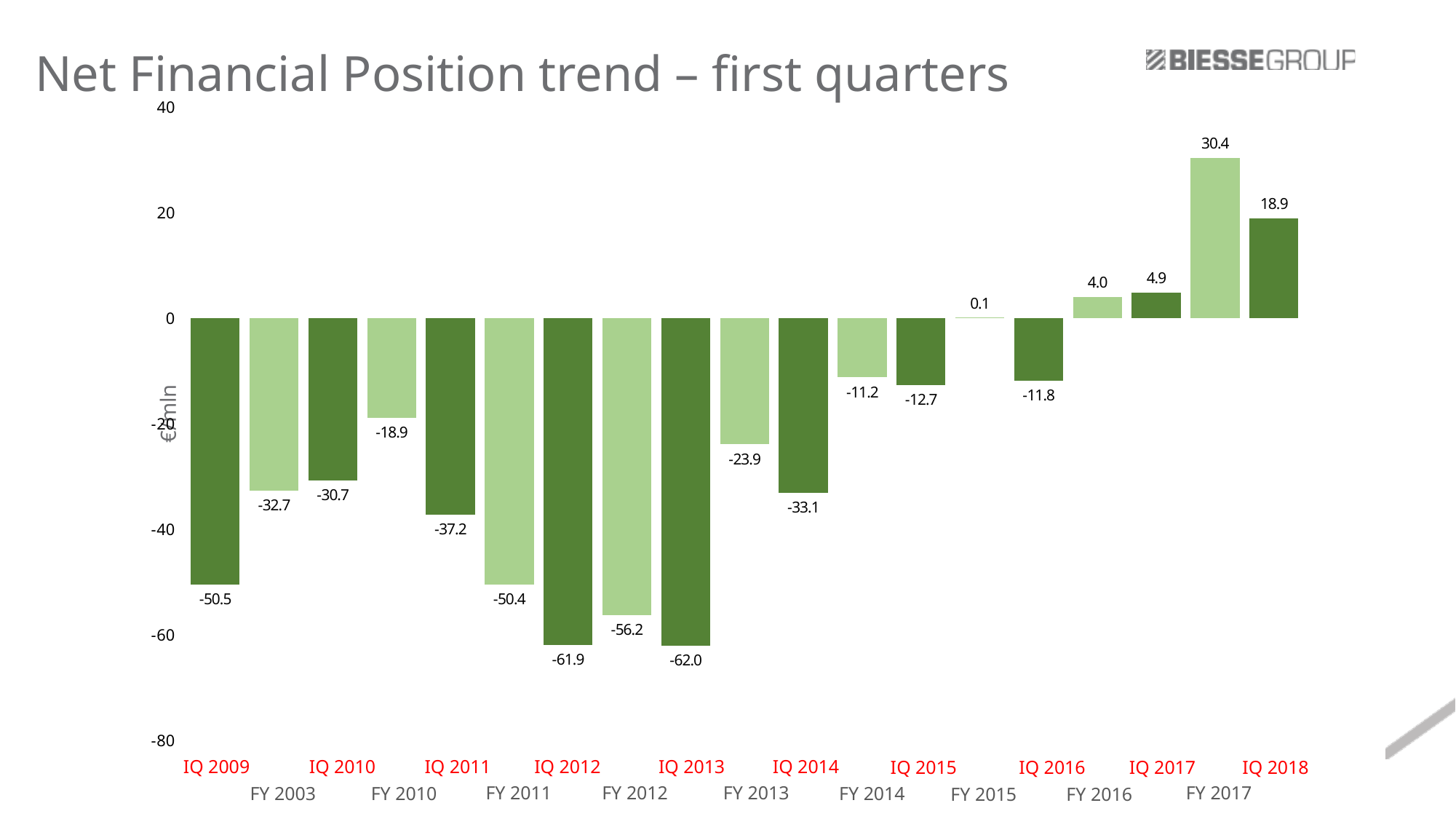
Which is larger, the value for IQ 2009 or the value for IQ 2010? IQ 2010 What is the value shown for FY 2015? 0.1 What is the Net Financial Position value for IQ 2018? 18.9 How many bars are plotted in the chart? 19 Do the values generally rise or fall from IQ 2013 to IQ 2018? Rise Which period has the lowest Net Financial Position value? IQ 2013 Which period has the highest Net Financial Position value? FY 2017 What is the value shown for IQ 2013? -62.0 What is the difference between the values for IQ 2018 and IQ 2017? 14.0 What unit is shown on the vertical axis of the chart? €mln What is the value shown for FY 2017? 30.4 What kind of chart is shown on the slide? Bar chart